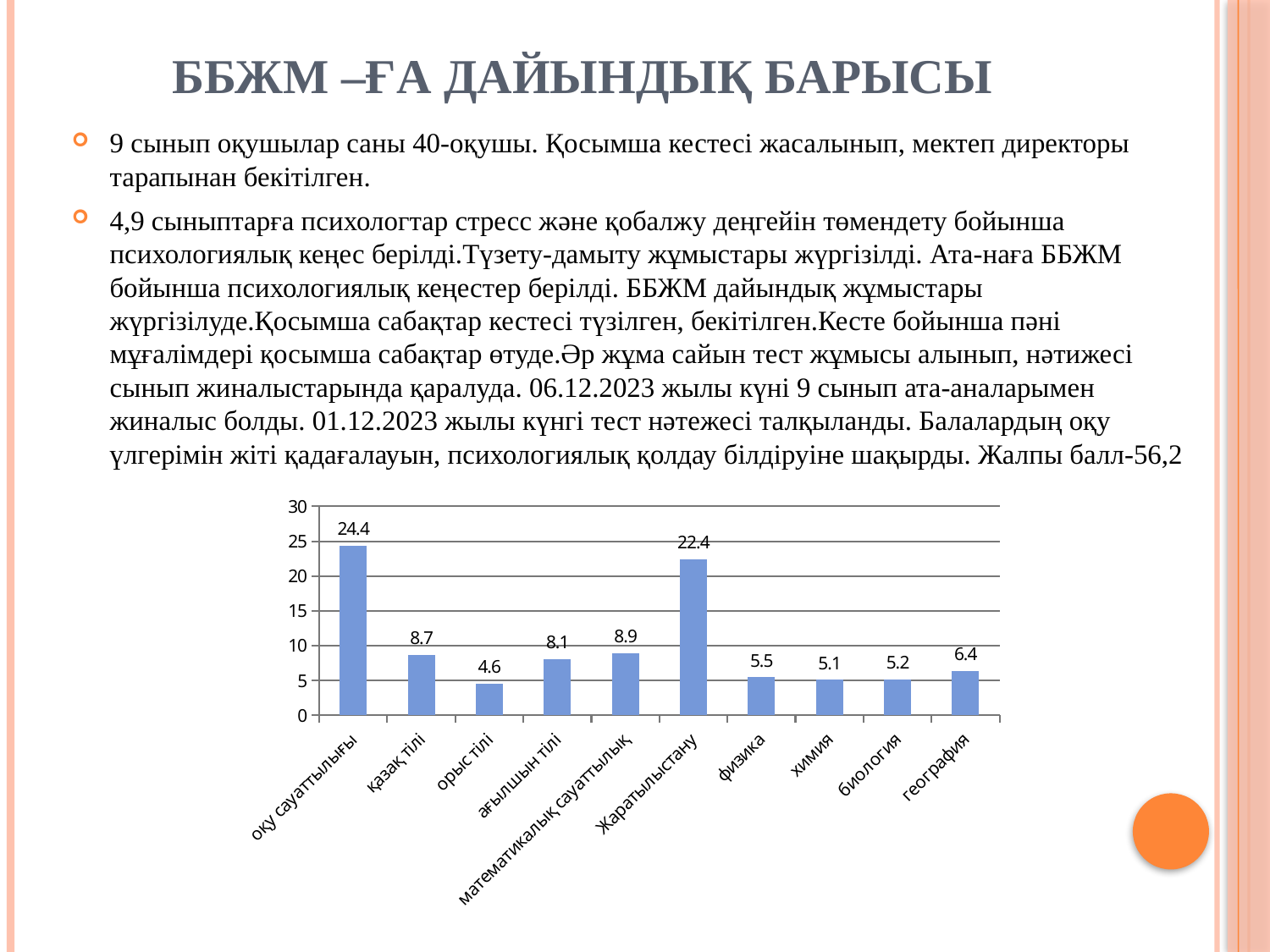
What is the value for география? 6.4 How many categories are plotted in the chart? 10 What kind of chart is shown on the slide? bar chart Which is larger, the value for қазақ тілі or the value for ағылшын тілі? қазақ тілі Which category has the highest value? оқу сауаттылығы What is the value for Жаратылыстану? 22.4 What is the difference between the values for оқу сауаттылығы and Жаратылыстану? 2 What is the value for оқу сауаттылығы? 24.4 What is the value for математикалық сауаттылық? 8.9 Is the value for физика greater or less than 10? less Which category has the lowest value? орыс тілі What is the difference between the values for химия and биология? 0.1